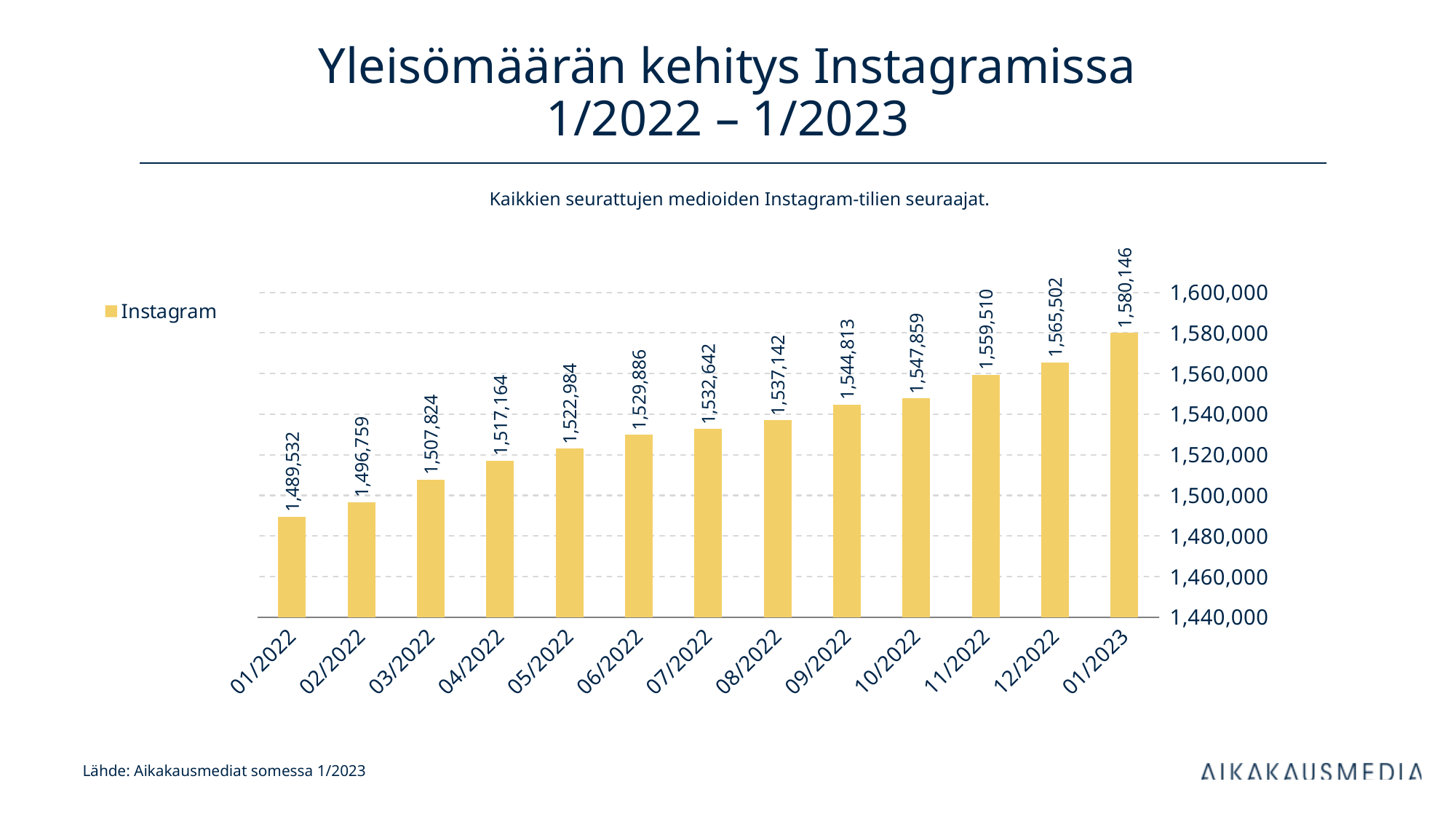
Which month has the lowest value? 01/2022 How many months are shown on the x axis? 13 What is the difference between the values for 12/2022 and 11/2022? 5,992 Is the value for 03/2022 greater or less than 1,500,000? greater What is the Instagram follower count for 01/2022? 1,489,532 Do the values rise or fall from 01/2022 to 01/2023? Rise Which is larger, the value for 04/2022 or the value for 09/2022? 09/2022 Which month has the highest value? 01/2023 What is the value shown for 12/2022? 1,565,502 What kind of chart is shown on the slide? Bar chart What is the value shown for 07/2022? 1,532,642 What is the difference between the values for 01/2023 and 01/2022? 90,614